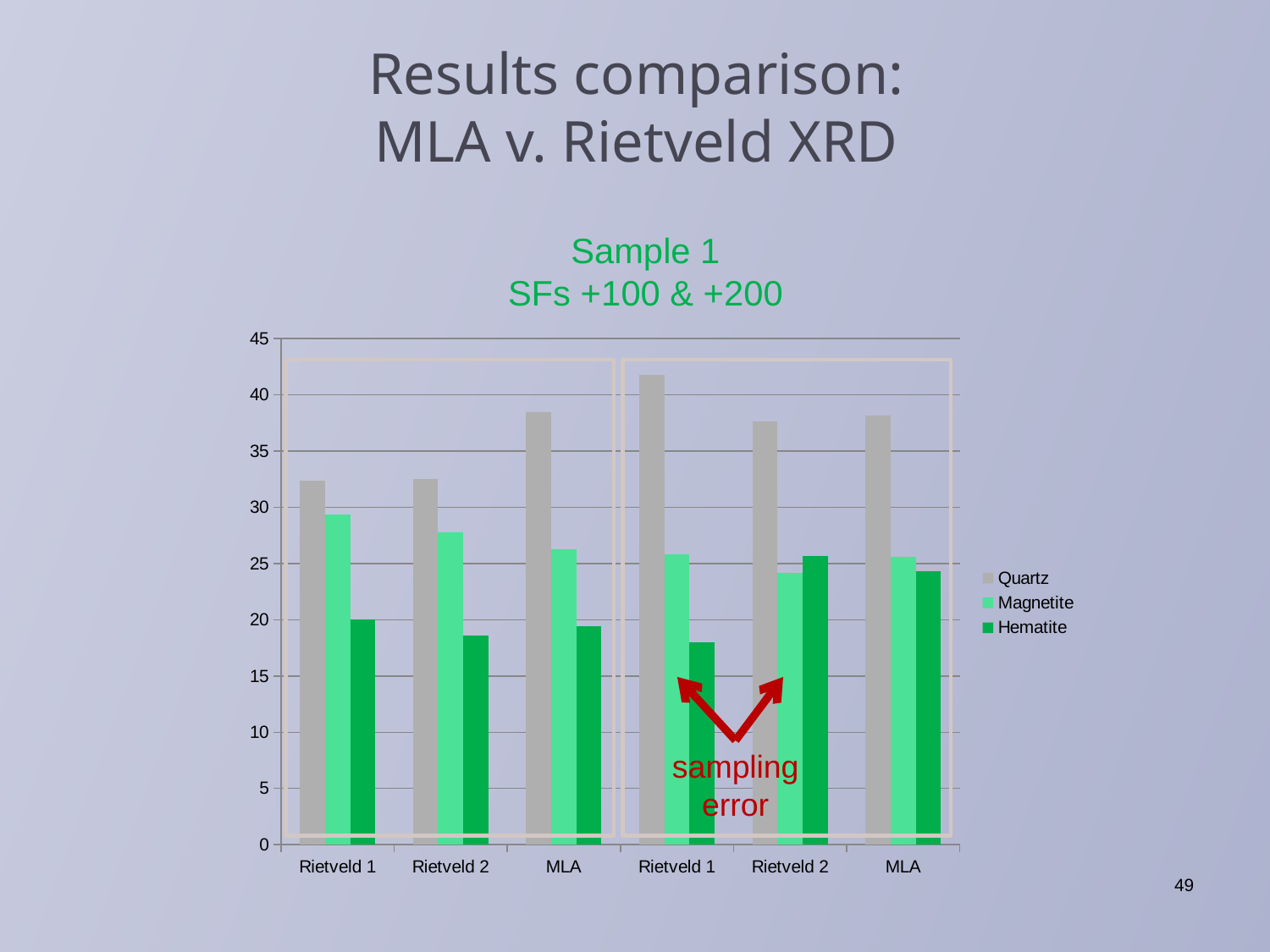
What kind of chart is shown on the slide? bar chart Is the Quartz value for the left-hand MLA group greater or less than 40? less Is the Hematite value for the left-hand Rietveld 2 group greater or less than 20? less Is the Quartz value for the right-hand Rietveld 1 group greater or less than 40? greater Which category group has the highest Quartz bar? Rietveld 1 (right-hand group) What is the title shown above the chart? Sample 1 SFs +100 & +200 Which series is shown in grey in the legend? Quartz How many series does the legend list? 3 In the right-hand Rietveld 1 group, which is larger, Magnetite or Hematite? Magnetite How many category groups are shown along the x axis? 6